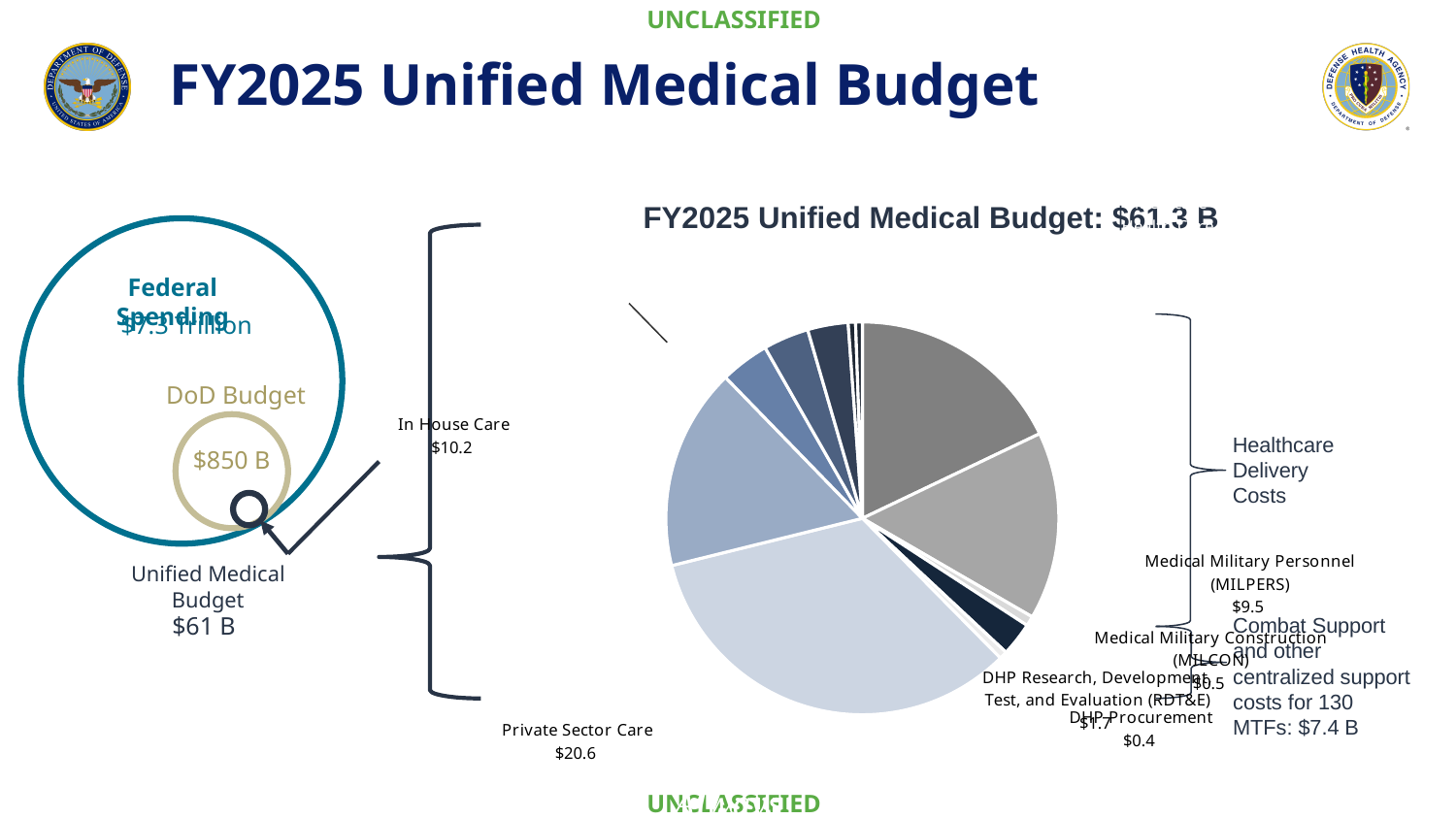
What kind of chart is used to show the FY2025 Unified Medical Budget breakdown? Pie chart Which labeled category has the largest slice of the pie chart? Private Sector Care What is the difference between Private Sector Care ($20.6) and In House Care ($10.2)? $10.4 What is the value shown for Private Sector Care in the pie chart? $20.6 What is the value shown for DHP Procurement? $0.4 What is the title of the pie chart? FY2025 Unified Medical Budget: $61.3 B What is the value shown for Medical Military Personnel (MILPERS)? $9.5 What is the value shown for In House Care in the pie chart? $10.2 Which is larger, In House Care or Private Sector Care? Private Sector Care What is the value shown for Medical Military Construction (MILCON)? $0.5 What is the value shown for DHP Research, Development, Test, and Evaluation (RDT&E)? $1.7 What is the difference between Medical Military Personnel (MILPERS) ($9.5) and DHP RDT&E ($1.7)? $7.8